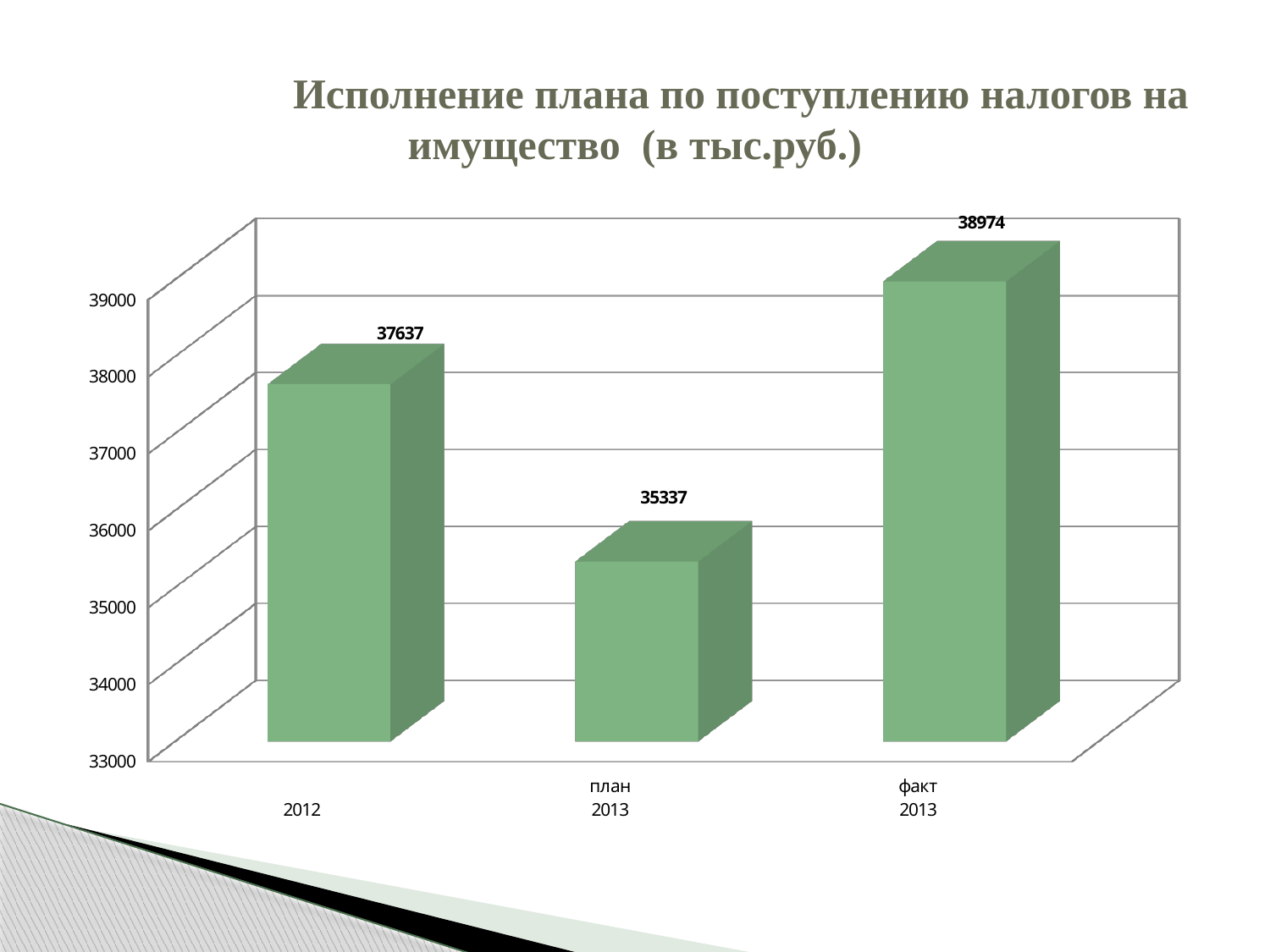
What is the title of the chart? Исполнение плана по поступлению налогов на имущество (в тыс.руб.) Which is larger, the value for 2012 or the value for план 2013? 2012 What is the value for факт 2013? 38974 What is the difference between факт 2013 and 2012? 1337 What is the difference between факт 2013 and план 2013? 3637 Is the value for план 2013 greater or less than 36000? less Which category has the lowest value? план 2013 Which category has the highest value? факт 2013 What kind of chart is shown on the slide? bar chart How many bars are shown in the chart? 3 What is the value for 2012? 37637 What is the value for план 2013? 35337